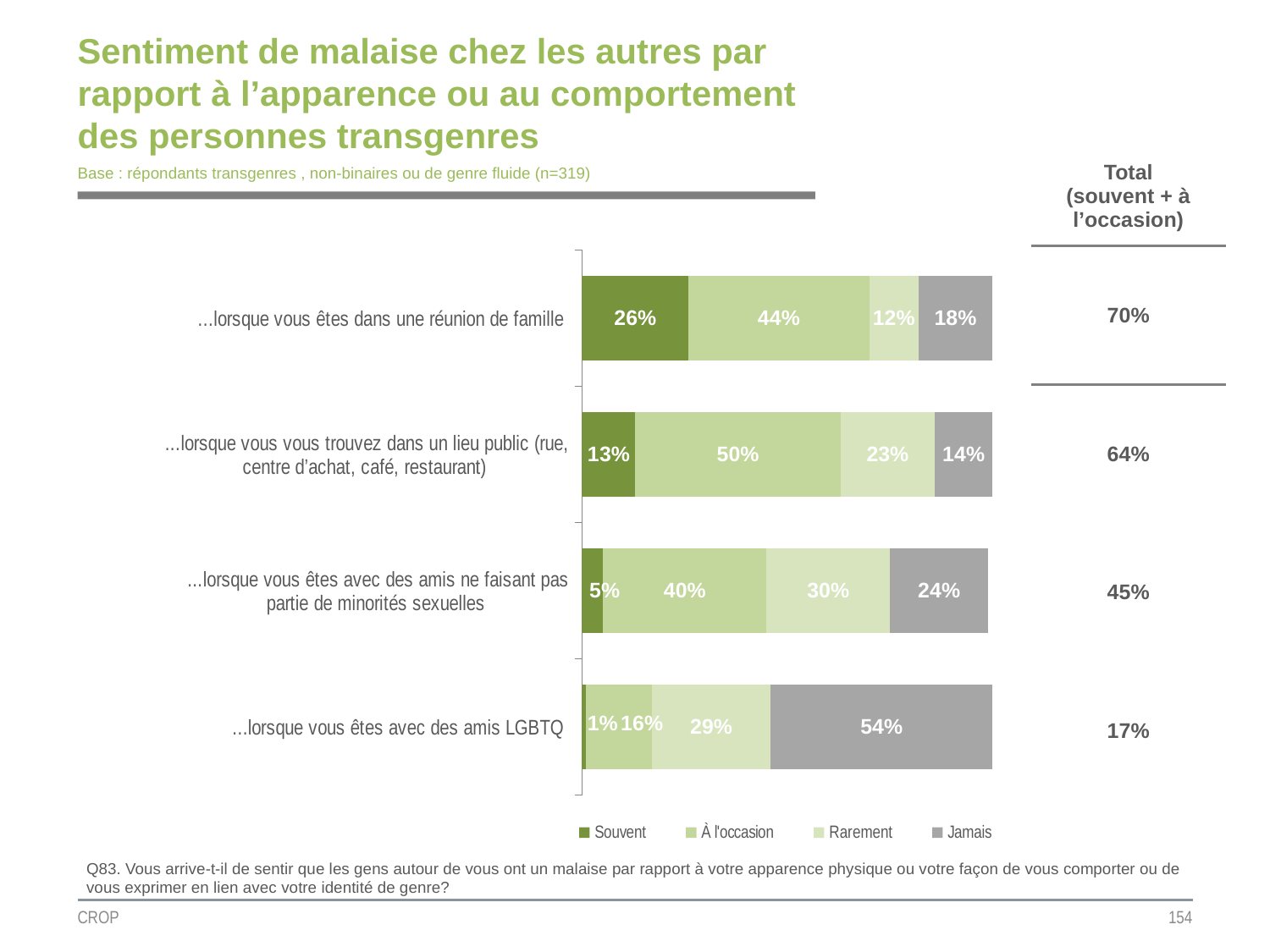
Which category has the lowest 'Jamais' value? ...lorsque vous vous trouvez dans un lieu public (rue, centre d'achat, café, restaurant) What is the 'Total (souvent + à l'occasion)' value shown for '...lorsque vous êtes avec des amis LGBTQ'? 17% What is the 'Rarement' value for '...lorsque vous êtes avec des amis ne faisant pas partie de minorités sexuelles'? 30% What is the 'Souvent' value for '...lorsque vous êtes dans une réunion de famille'? 26% Which category has the highest 'Souvent' value? ...lorsque vous êtes dans une réunion de famille How many series does the legend list? 4 How many categories are shown in the chart? 4 Which is larger: the 'À l'occasion' value for '...lorsque vous êtes dans une réunion de famille' or for '...lorsque vous êtes avec des amis ne faisant pas partie de minorités sexuelles'? ...lorsque vous êtes dans une réunion de famille What is the 'Jamais' value for '...lorsque vous êtes avec des amis LGBTQ'? 54% What kind of chart is shown on the slide? Stacked bar chart What is the 'À l'occasion' value for '...lorsque vous vous trouvez dans un lieu public (rue, centre d'achat, café, restaurant)'? 50% What is the difference between the 'Jamais' values for '...lorsque vous êtes avec des amis LGBTQ' and '...lorsque vous êtes dans une réunion de famille'? 36%